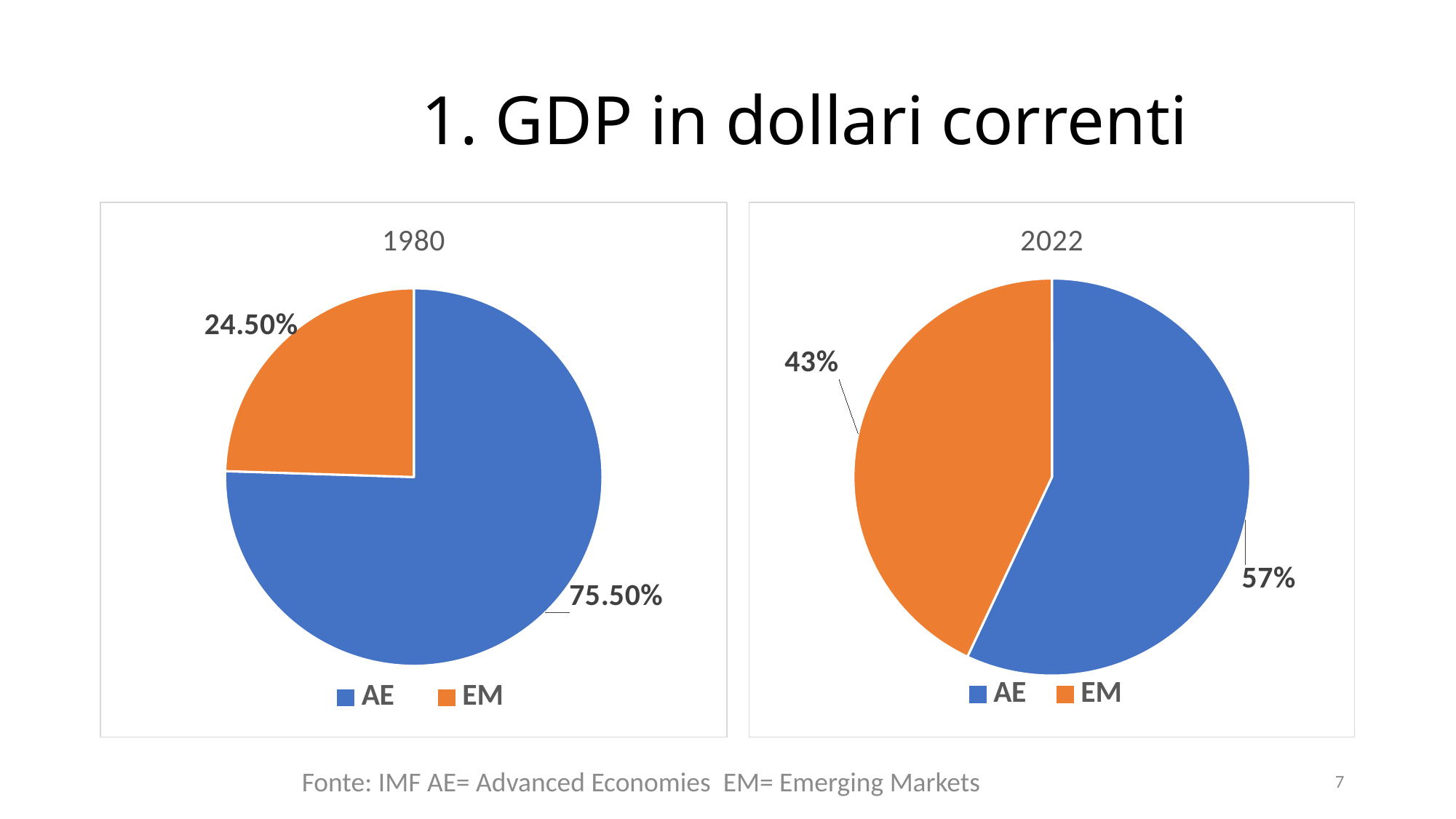
In the 2022 chart, which category has the smallest slice? EM What kind of chart is the 1980 chart? pie chart How many slices does the 2022 pie chart have? 2 In the 2022 chart, what share of GDP is labelled for EM? 43% In the 1980 chart, what is the difference between the AE and EM shares? 51.00% In the 1980 chart, what share of GDP is labelled for EM? 24.50% In the 1980 chart, what colour is the EM slice? orange In the 2022 chart, what is the difference between the AE and EM shares? 14% In the 1980 chart, what share of GDP is labelled for AE? 75.50% In the 1980 chart, which category has the largest slice? AE In the 2022 chart, is the AE slice larger or smaller than the EM slice? larger In the 2022 chart, what share of GDP is labelled for AE? 57%